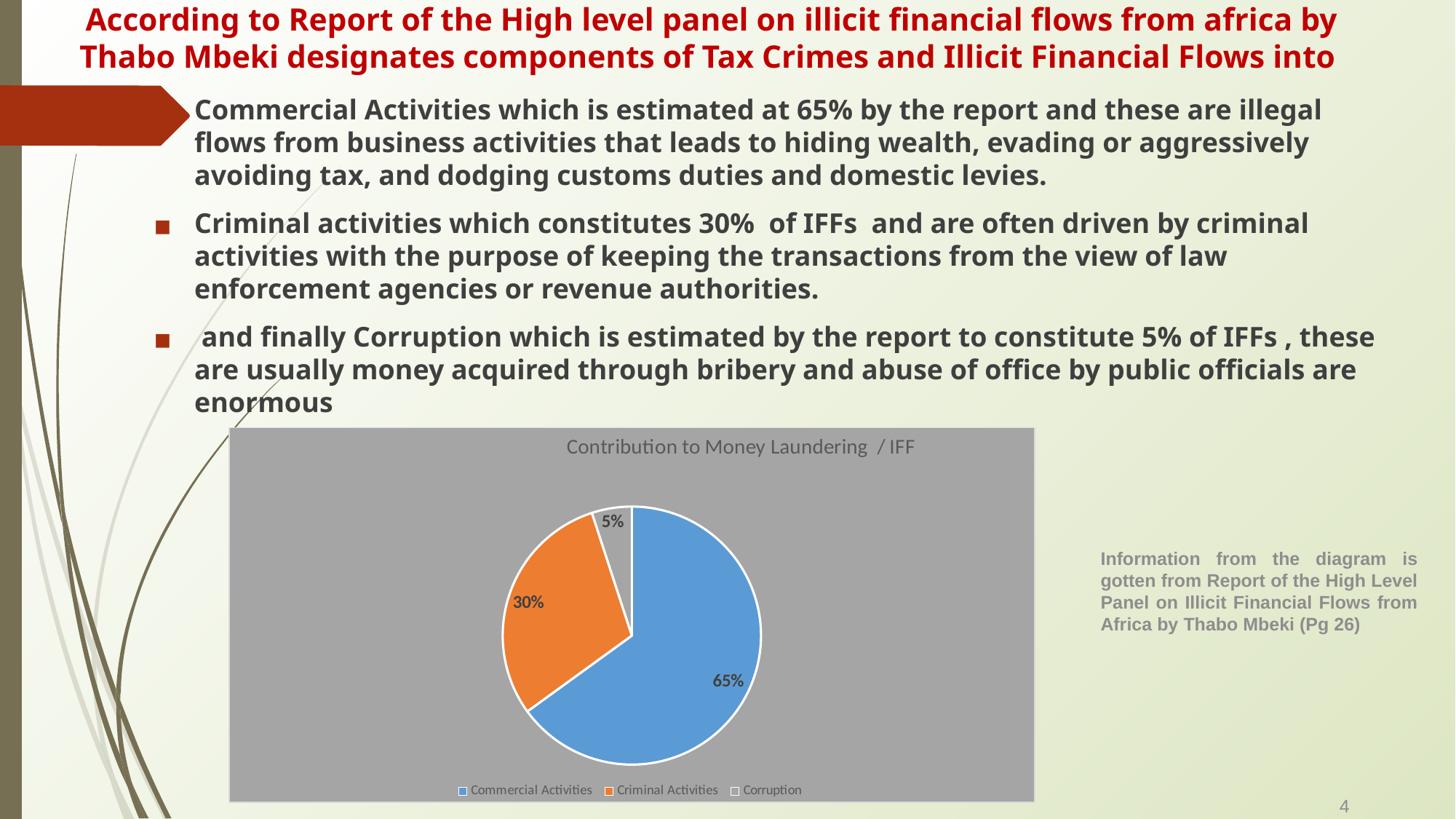
What is the difference in percentage points between Commercial Activities and Criminal Activities? 35 Which category has the largest slice of the pie? Commercial Activities What is the title of the chart? Contribution to Money Laundering / IFF What share of the pie is Corruption? 5% What colour is the Criminal Activities slice? orange How many entries does the legend list? 3 What share of the pie is Criminal Activities? 30% What share of the pie is Commercial Activities? 65% Which category has the smallest slice of the pie? Corruption Which is larger, the Criminal Activities slice or the Corruption slice? Criminal Activities What type of chart is shown on the slide? pie chart How many slices does the pie chart have? 3